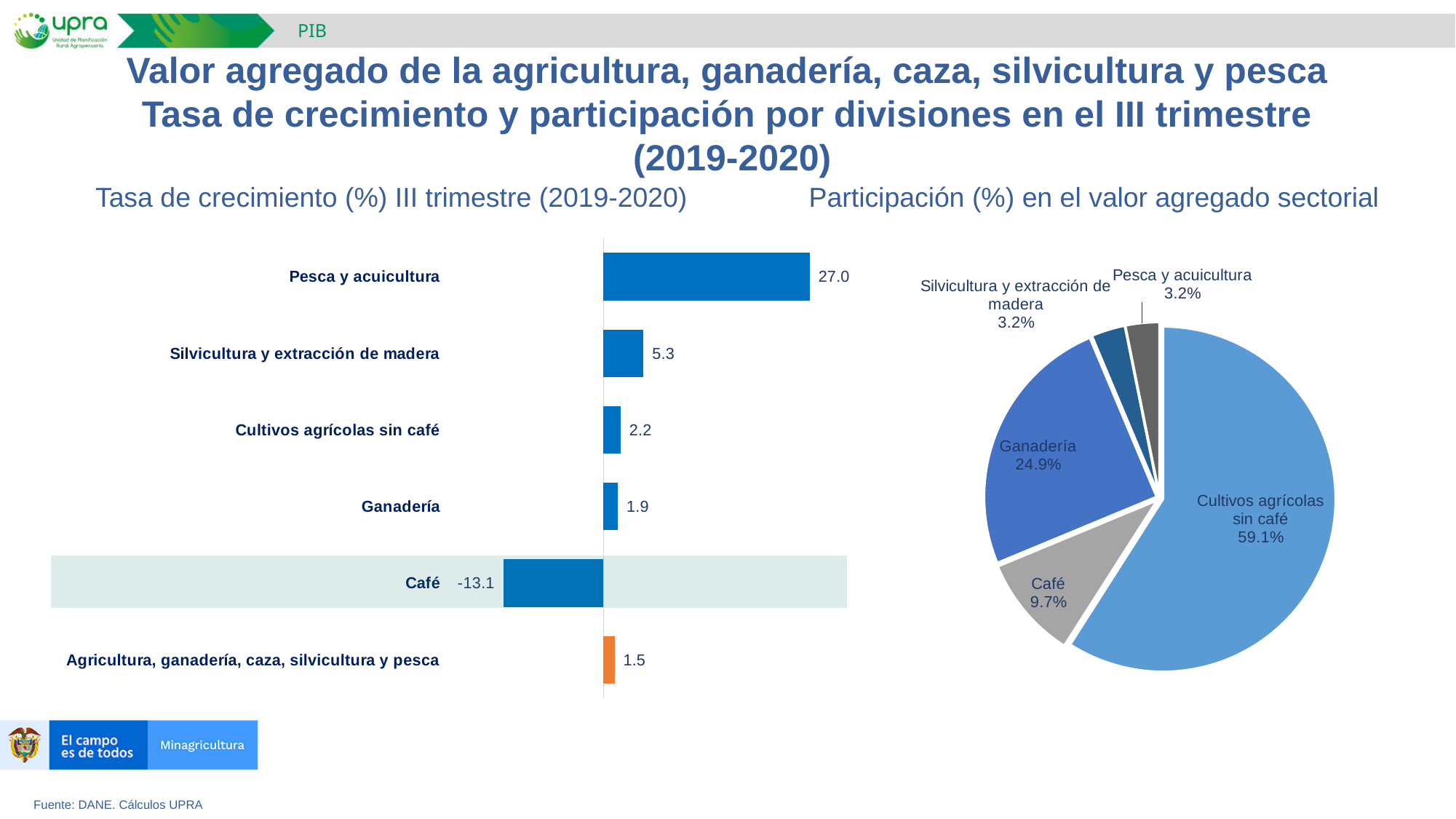
In the 'Participación (%) en el valor agregado sectorial' pie chart, what share does Ganadería have? 24.9% What kind of chart is the 'Participación (%) en el valor agregado sectorial' chart? Pie chart What kind of chart is the 'Tasa de crecimiento (%) III trimestre (2019-2020)' chart? Bar chart In the 'Tasa de crecimiento (%) III trimestre (2019-2020)' chart, what is the value for Pesca y acuicultura? 27.0 In the 'Tasa de crecimiento (%) III trimestre (2019-2020)' chart, which category has the highest value? Pesca y acuicultura In the 'Participación (%) en el valor agregado sectorial' pie chart, which slice is the largest? Cultivos agrícolas sin café How many categories are shown in the 'Tasa de crecimiento (%) III trimestre (2019-2020)' chart? 6 In the 'Tasa de crecimiento (%) III trimestre (2019-2020)' chart, which category has the lowest value? Café In the 'Participación (%) en el valor agregado sectorial' pie chart, what is the difference between the shares of Cultivos agrícolas sin café and Café? 49.4% In the 'Tasa de crecimiento (%) III trimestre (2019-2020)' chart, what is the difference between the values for Pesca y acuicultura and Silvicultura y extracción de madera? 21.7 In the 'Tasa de crecimiento (%) III trimestre (2019-2020)' chart, what is the value for Café? -13.1 In the 'Tasa de crecimiento (%) III trimestre (2019-2020)' chart, which is larger: the value for Cultivos agrícolas sin café or the value for Ganadería? Cultivos agrícolas sin café